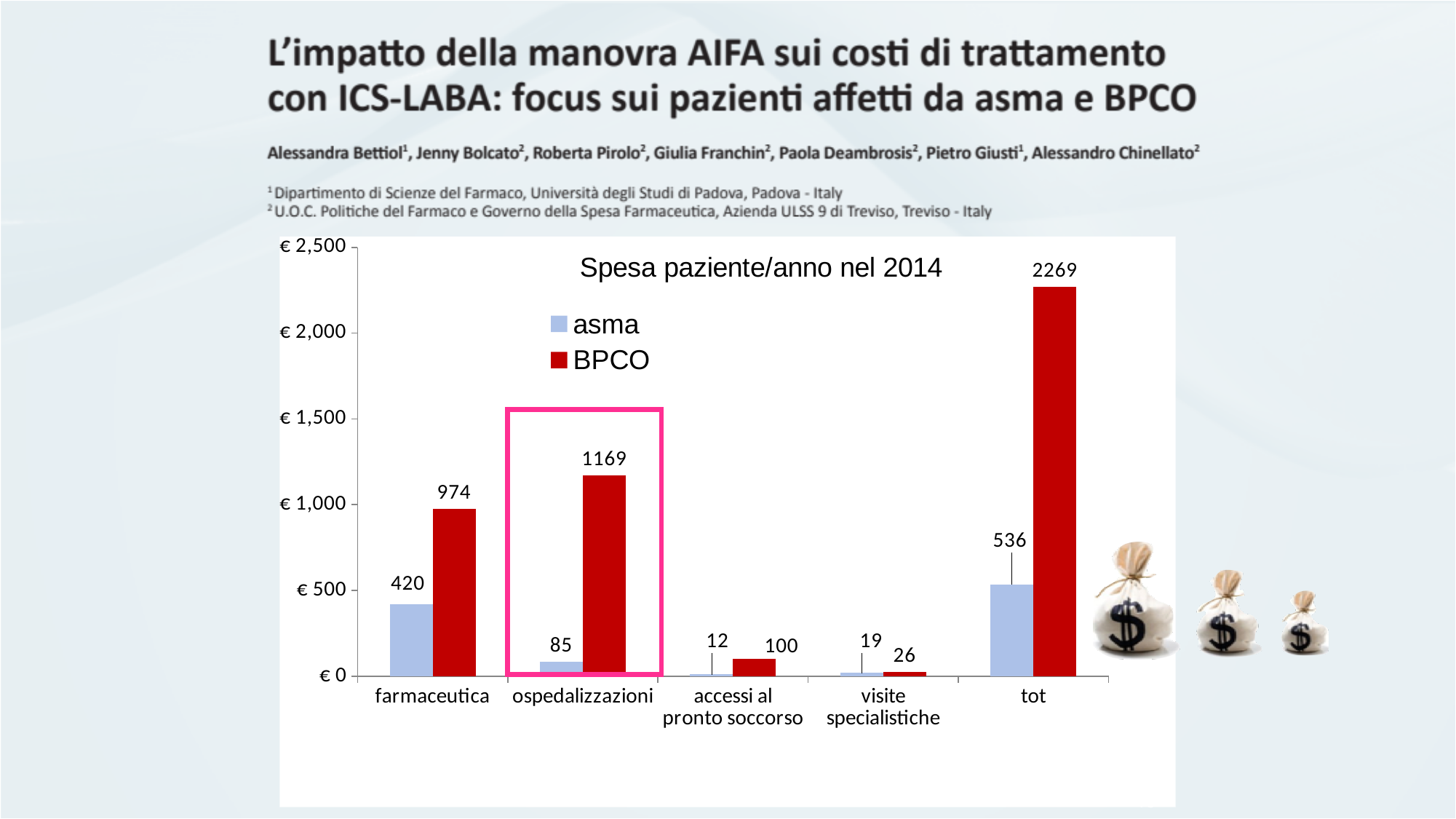
What is the asma value for farmaceutica? 420 What is the BPCO value for tot? 2269 What kind of chart is shown? bar chart Which is larger for accessi al pronto soccorso, the asma value or the BPCO value? BPCO Which category has the lowest asma value? accessi al pronto soccorso How many series does the legend list? 2 How many categories are shown on the x axis? 5 What is the difference between the BPCO and asma values for farmaceutica? 554 Which category has the highest BPCO value? tot What is the BPCO value for ospedalizzazioni? 1169 What is the asma value for visite specialistiche? 19 What is the title of the chart? Spesa paziente/anno nel 2014